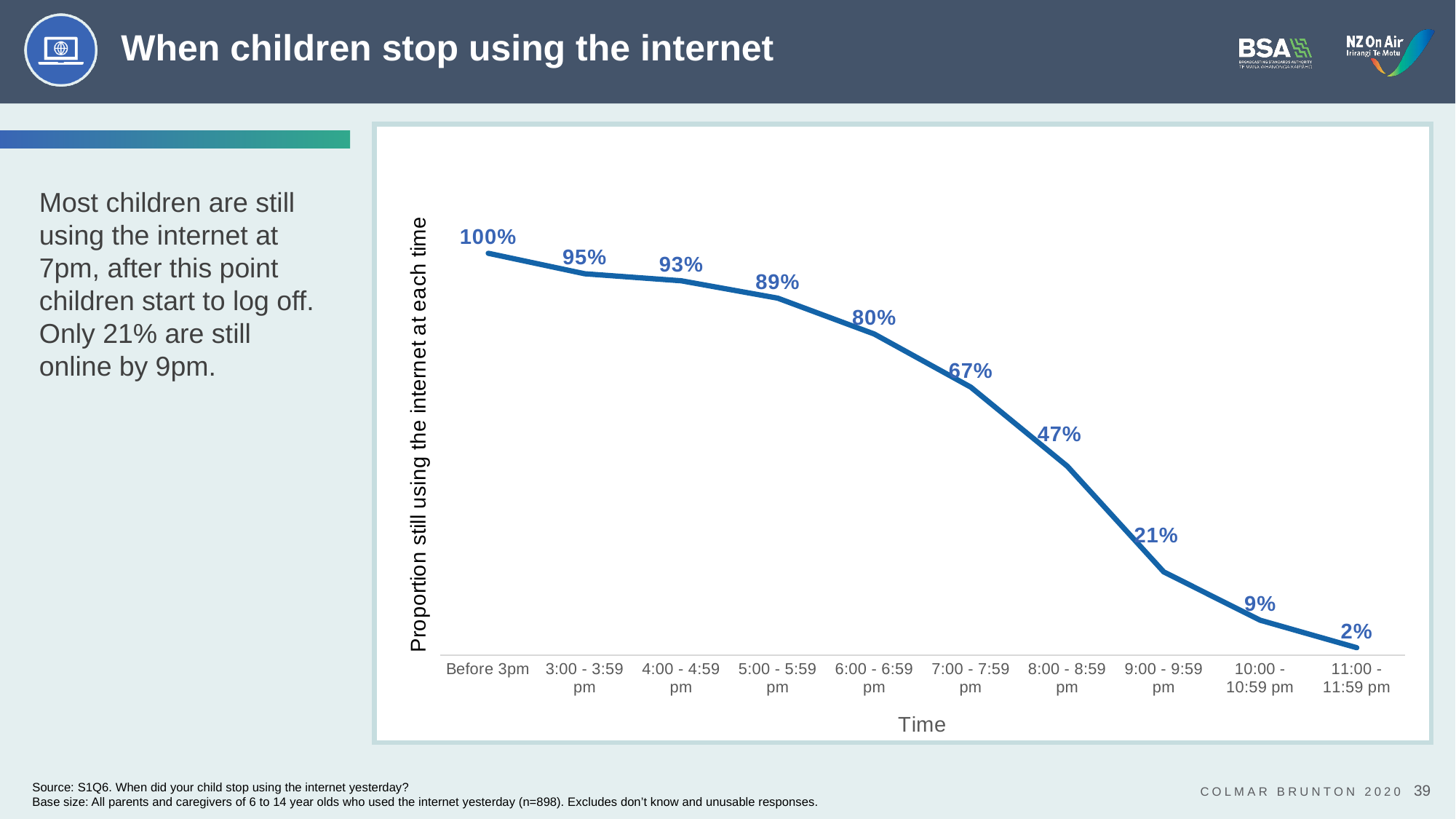
Which time slot has the lowest proportion still using the internet? 11:00 - 11:59 pm What is the label of the x axis? Time What is the difference between the values for 7:00 - 7:59 pm and 8:00 - 8:59 pm? 20% What proportion of children are still using the internet at 9:00 - 9:59 pm? 21% What proportion of children are still using the internet at 7:00 - 7:59 pm? 67% What is the difference between the values for 6:00 - 6:59 pm and 9:00 - 9:59 pm? 59% What is the value for 4:00 - 4:59 pm? 93% What kind of chart is shown on the slide? Line chart How many time slots are plotted on the x axis? 10 Which is larger, the value for 5:00 - 5:59 pm or the value for 8:00 - 8:59 pm? 5:00 - 5:59 pm Do the values rise or fall as time moves from left to right along the x axis? Fall Which time slot has the highest proportion still using the internet? Before 3pm